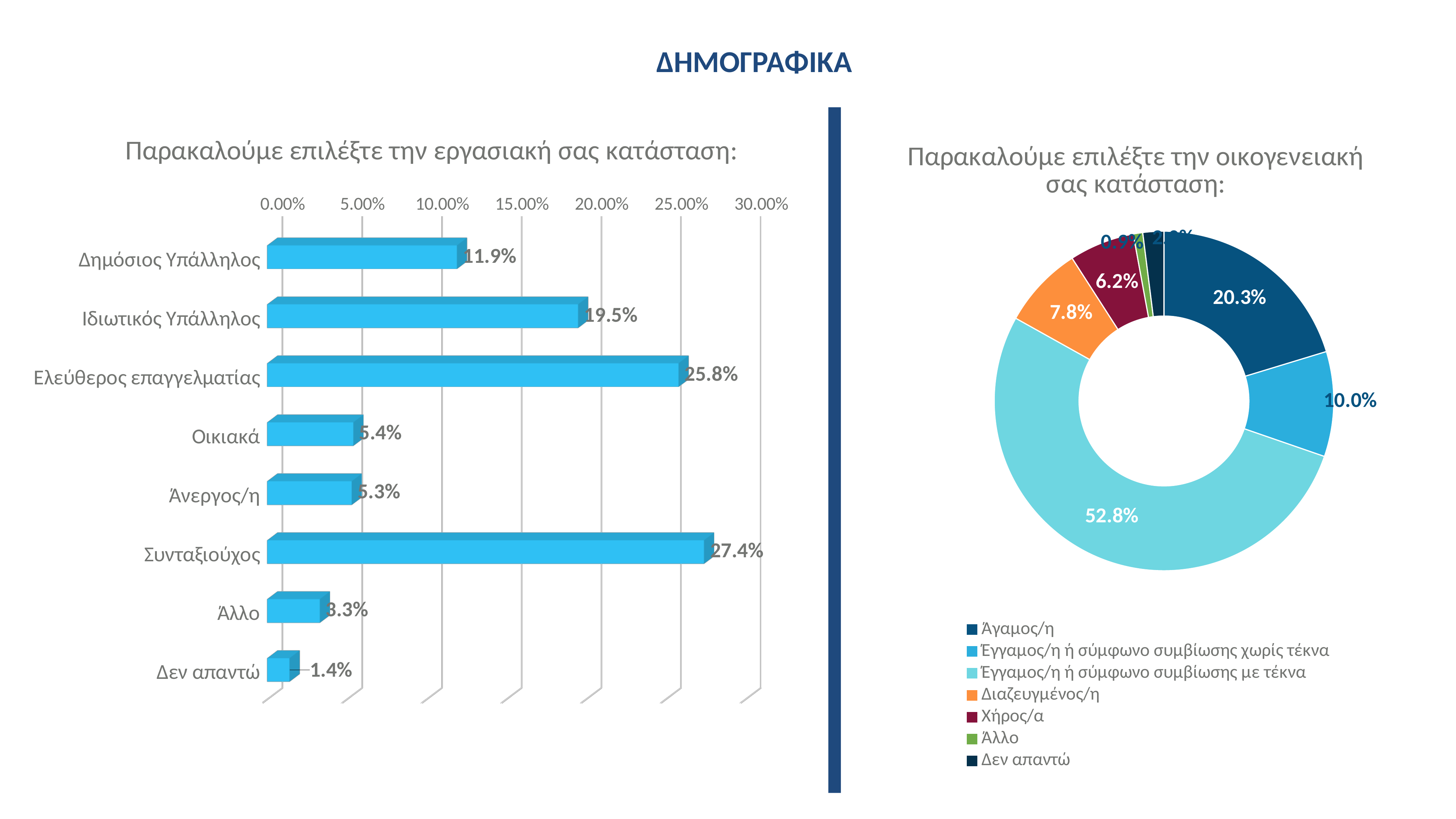
In the right chart (family status), which category has the largest share? Έγγαμος/η ή σύμφωνο συμβίωσης με τέκνα What kind of chart is the left chart (employment status)? Bar chart In the right chart (family status), what is the share for Διαζευγμένος/η? 7.8% In the right chart (family status), what is the share for Έγγαμος/η ή σύμφωνο συμβίωσης με τέκνα? 52.8% In the left chart (employment status), what is the value for Ιδιωτικός Υπάλληλος? 19.5% In the left chart (employment status), which category has the lowest value? Δεν απαντώ In the left chart (employment status), what is the difference between Ελεύθερος επαγγελματίας and Δημόσιος Υπάλληλος? 13.9% In the left chart (employment status), which category has the highest value? Συνταξιούχος In the left chart (employment status), how many categories are shown? 8 How many entries does the legend of the right chart (family status) list? 7 In the left chart (employment status), which is larger: Ιδιωτικός Υπάλληλος or Δημόσιος Υπάλληλος? Ιδιωτικός Υπάλληλος In the left chart (employment status), what is the value for Συνταξιούχος? 27.4%